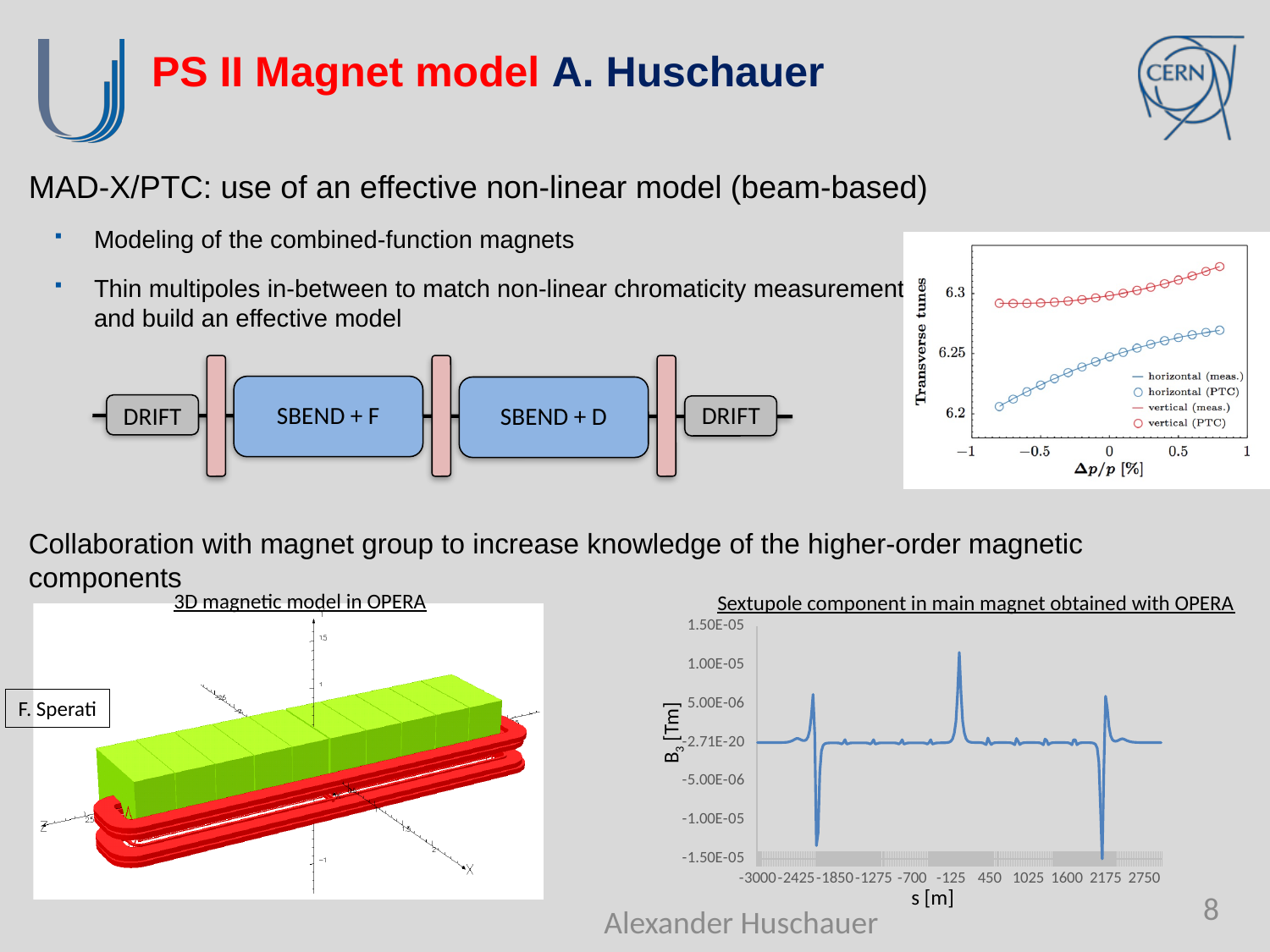
In the 'Sextupole component in main magnet obtained with OPERA' chart, what is the label of the x axis? s [m] In the transverse tunes chart (top right), is the horizontal tune at Δp/p = 0.8% greater or less than 6.25? greater How many entries does the legend of the transverse tunes chart (top right) list? 4 In the 'Sextupole component in main magnet obtained with OPERA' chart, what is the label of the y axis? B3 [Tm] In the transverse tunes chart (top right), which tune is higher across the plotted range, horizontal or vertical? vertical In the 'Sextupole component in main magnet obtained with OPERA' chart, is the lowest value of the dip near s = 2175 greater or less than -1.00E-05? less What kind of chart is the 'Sextupole component in main magnet obtained with OPERA' chart? line chart In the 'Sextupole component in main magnet obtained with OPERA' chart, which dip reaches a lower value: the one near s = -1850 or the one near s = 2175? the one near s = 2175 In the transverse tunes chart (top right), does the horizontal tune rise or fall as Δp/p increases? rise In the 'Sextupole component in main magnet obtained with OPERA' chart, is the lowest value of the dip near s = -1850 greater or less than -1.00E-05? less